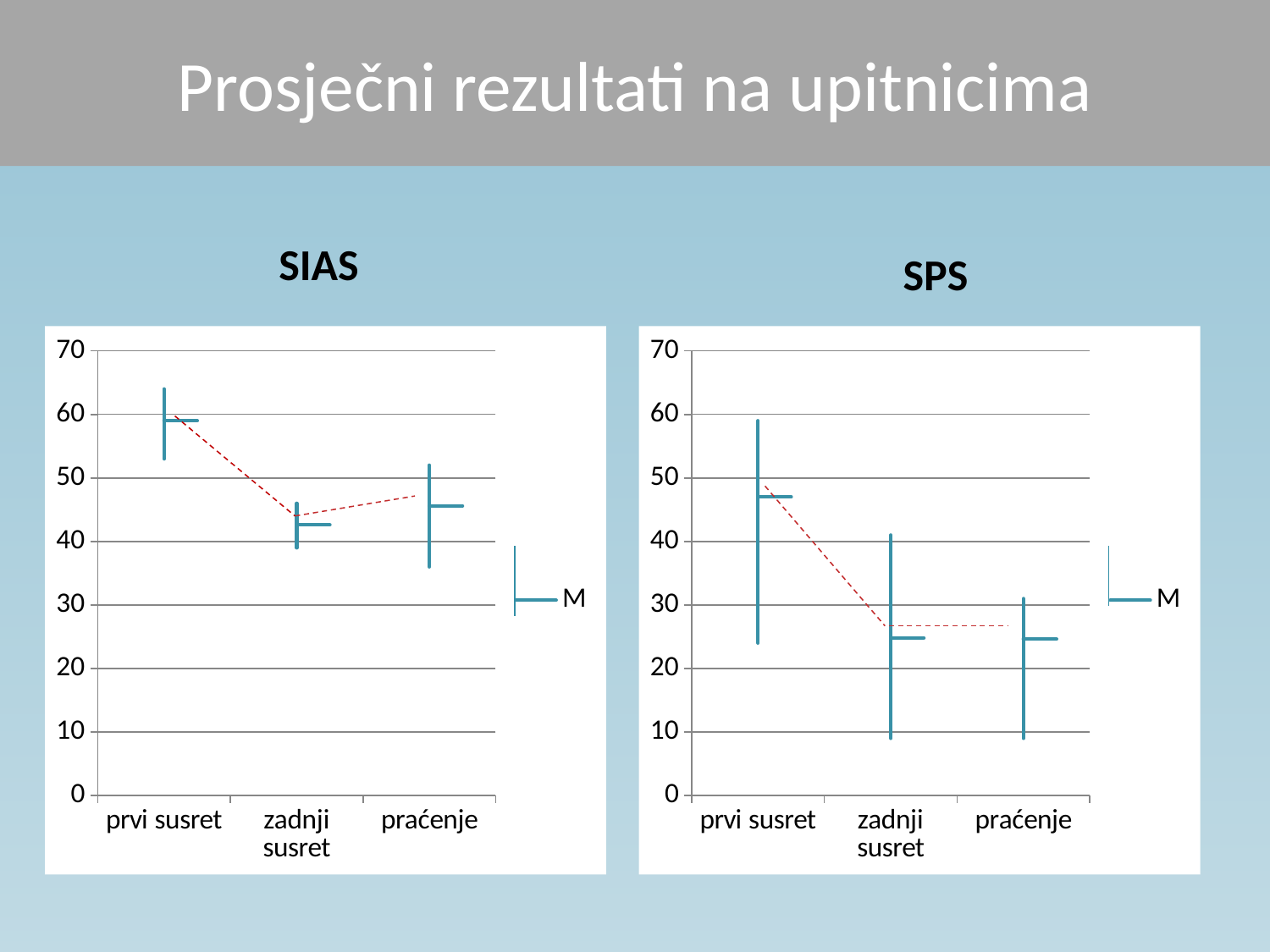
In the SIAS chart, which category has the lowest mean value? zadnji susret In the SIAS chart, which category has the highest mean value? prvi susret In the SIAS chart, is the mean value for prvi susret greater or less than 50? greater How many series does the legend of the SPS chart list? 1 In the SPS chart, which category has the highest mean value? prvi susret In the SPS chart, which has the larger mean value, prvi susret or zadnji susret? prvi susret In the SIAS chart, is the mean value for zadnji susret greater or less than 50? less In the SIAS chart, which has the larger mean value, zadnji susret or praćenje? praćenje What is the legend entry shown in the SIAS chart? M In the SPS chart, is the mean value for prvi susret greater or less than 40? greater How many categories are shown on the x axis of the SIAS chart? 3